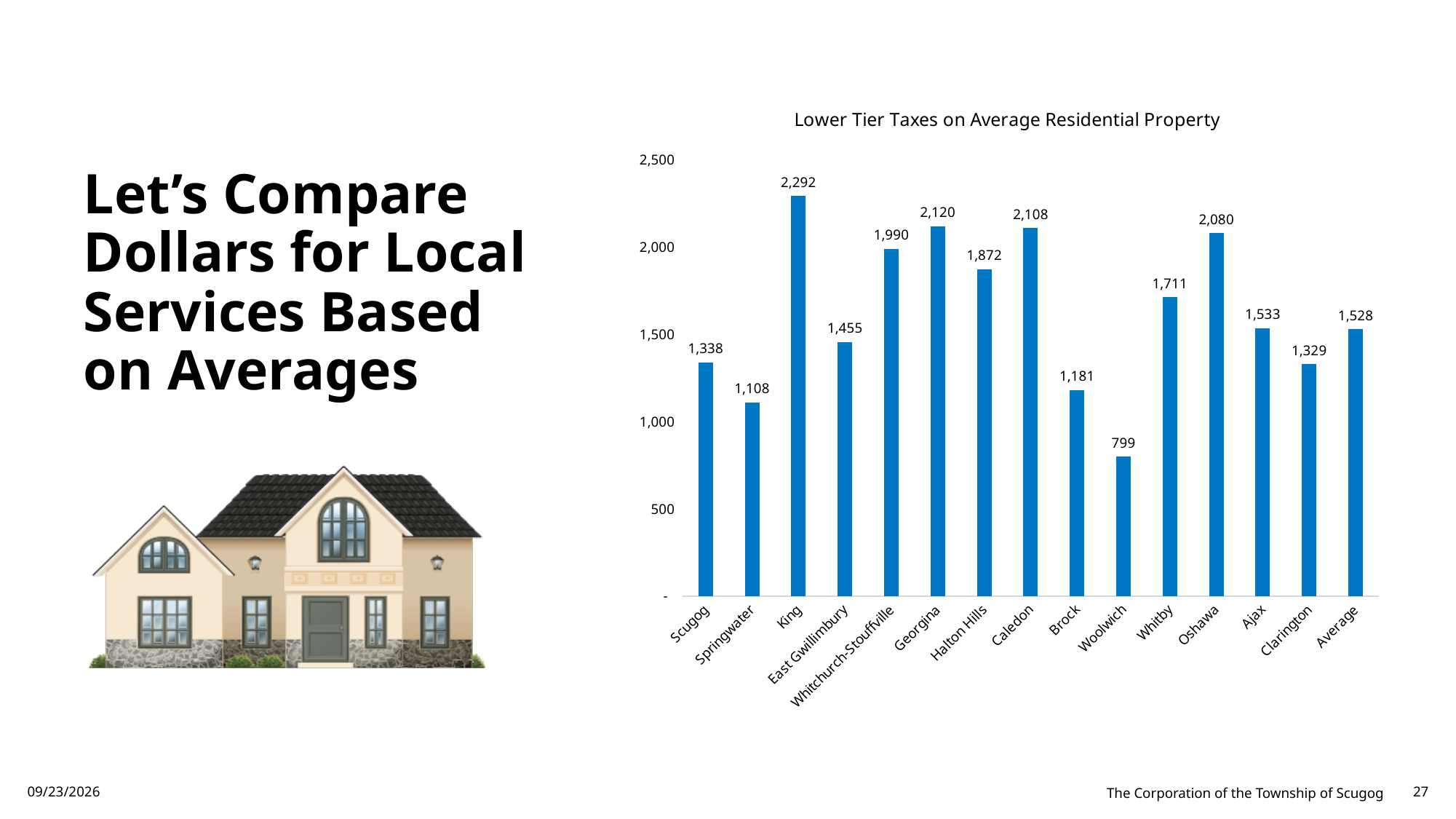
What is the difference between the values for King and Scugog? 954 Is the value for Brock greater or less than 1,500? less What is the value shown for Average? 1,528 Which municipality has the highest lower tier taxes on average residential property? King What kind of chart is shown on the slide? Bar chart How many bars are shown in the chart? 15 What is the value for Woolwich? 799 Which has a higher value, Whitby or Ajax? Whitby What is the title of the chart? Lower Tier Taxes on Average Residential Property What is the value for Scugog in the chart? 1,338 What is the difference between the Average value and the value for Scugog? 190 Which municipality has the lowest value in the chart? Woolwich